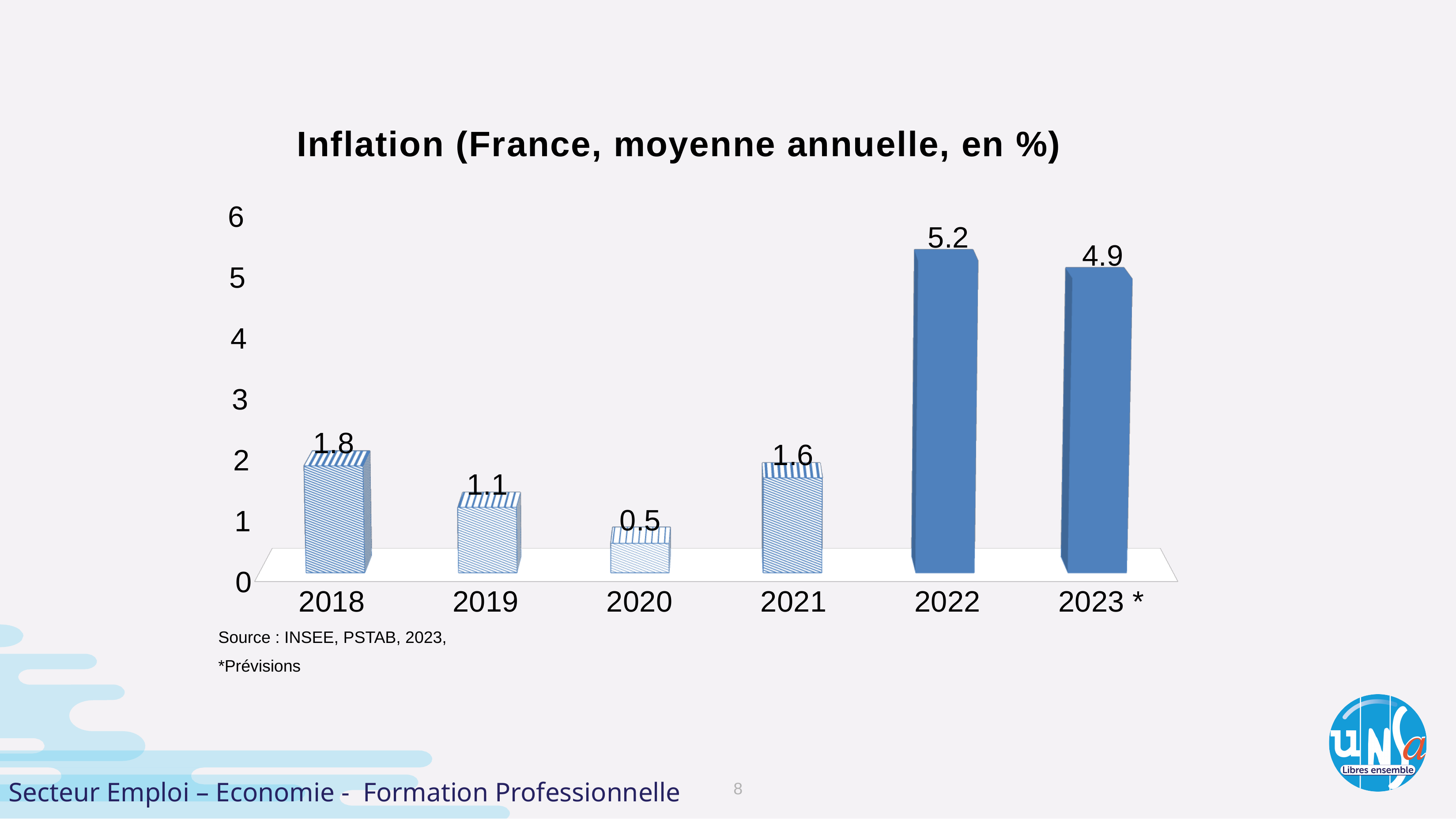
What is the inflation value shown for 2023 *? 4.9 Which year has the highest inflation value? 2022 What kind of chart is shown on the slide? bar chart What is the difference between the inflation values for 2022 and 2023 *? 0.3 What is the inflation value shown for 2020? 0.5 What is the inflation value shown for 2022? 5.2 Which is larger, the inflation value for 2018 or for 2021? 2018 Which year has the lowest inflation value? 2020 Is the value for 2022 greater or less than 4? greater What is the title of the chart? Inflation (France, moyenne annuelle, en %) How many years are shown on the x axis? 6 What is the difference between the inflation values for 2018 and 2019? 0.7